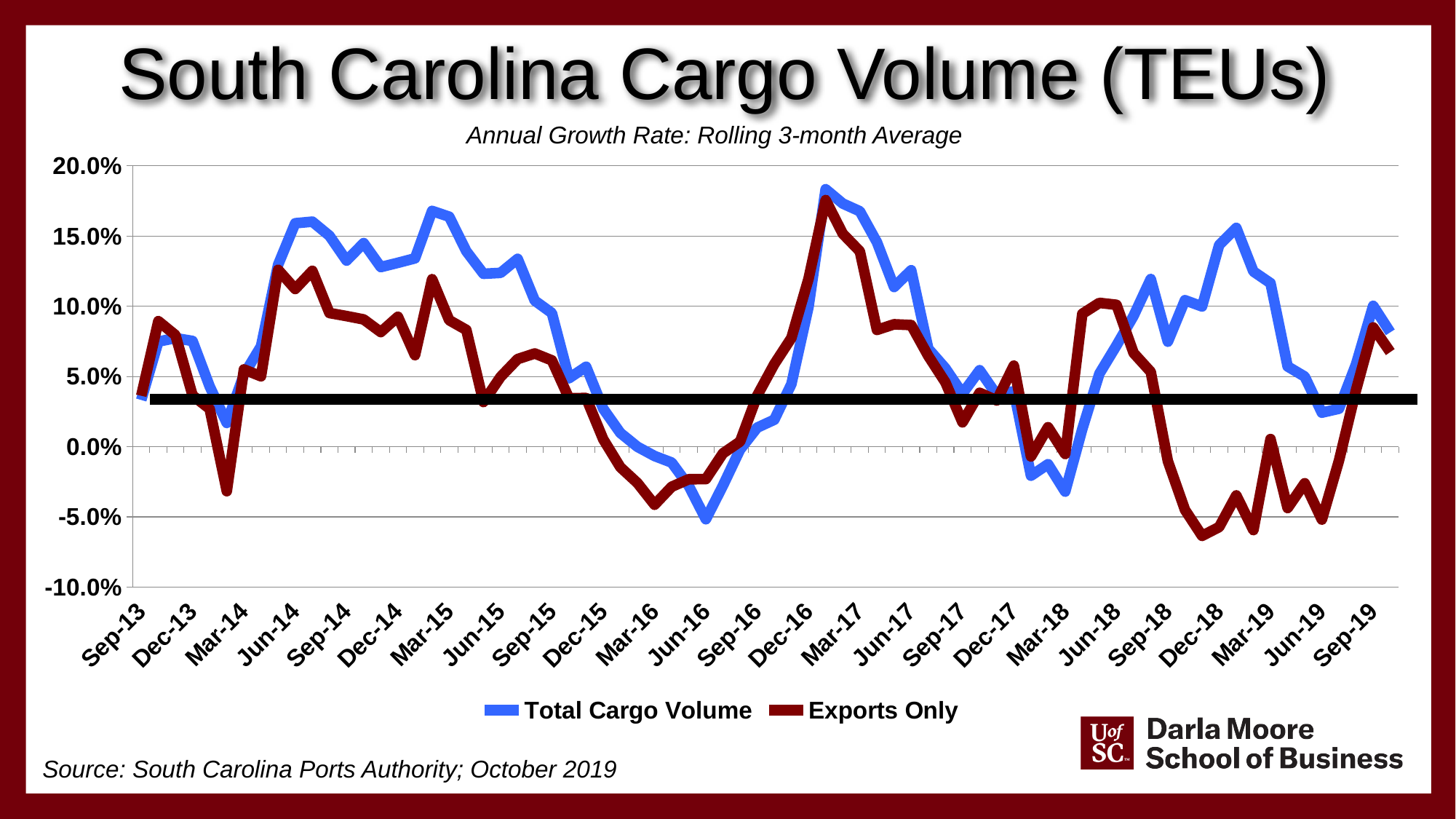
Is the value for Total Cargo Volume at Dec-16 greater or less than 15.0%? less What is the subtitle shown under the chart title? Annual Growth Rate: Rolling 3-month Average How many series does the legend list? 2 Is the value for Exports Only at Dec-18 greater or less than 0.0%? less Is the value for Total Cargo Volume at Jun-16 greater or less than 0.0%? less What are the two series named in the legend? Total Cargo Volume and Exports Only What kind of chart is shown on the slide? Line chart Does the Total Cargo Volume line rise or fall between Dec-18 and Jun-19? Fall At Dec-18, which series has the higher value, Total Cargo Volume or Exports Only? Total Cargo Volume Which series reaches the lowest value anywhere on the chart? Exports Only How many date labels are shown on the x axis? 25